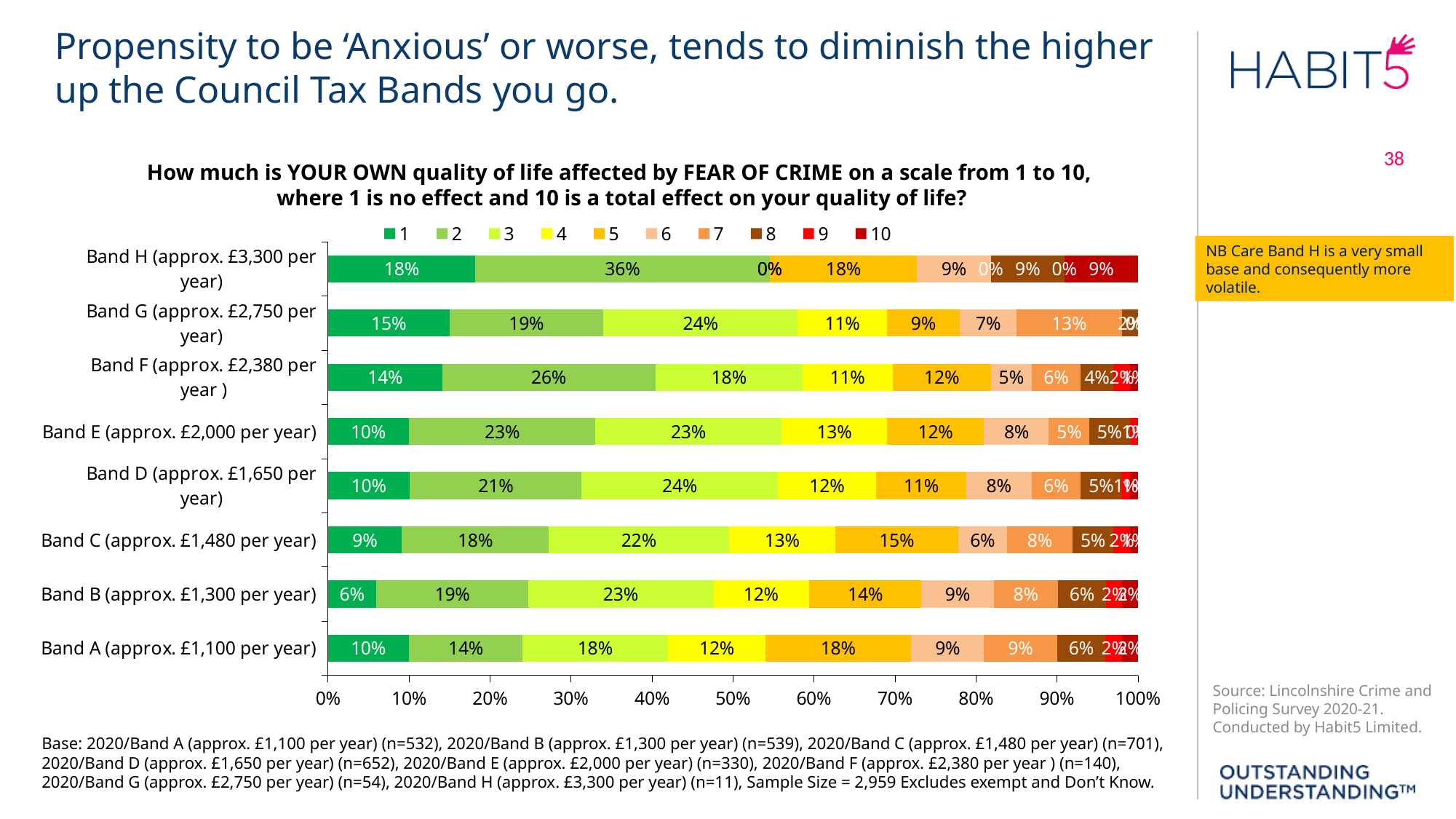
What percentage of Band A (approx. £1,100 per year) respondents gave a score of 5? 18% What percentage of Band D (approx. £1,650 per year) respondents gave a score of 3? 24% Which band has the highest percentage giving a score of 1? Band H (approx. £3,300 per year) What percentage of Band H (approx. £3,300 per year) respondents gave a score of 2? 36% Which has a larger percentage giving a score of 2: Band E (approx. £2,000 per year) or Band G (approx. £2,750 per year)? Band E (approx. £2,000 per year) What percentage of Band G (approx. £2,750 per year) respondents gave a score of 3? 24% What kind of chart is shown on the slide? Stacked bar chart How many series does the legend list? 10 How many Council Tax Bands are plotted on the chart? 8 What is the title of the chart? How much is YOUR OWN quality of life affected by FEAR OF CRIME on a scale from 1 to 10, where 1 is no effect and 10 is a total effect on your quality of life? What is the difference between the percentage giving a score of 2 in Band F (approx. £2,380 per year) and in Band A (approx. £1,100 per year)? 12 percentage points Which band has the lowest percentage giving a score of 1? Band B (approx. £1,300 per year)